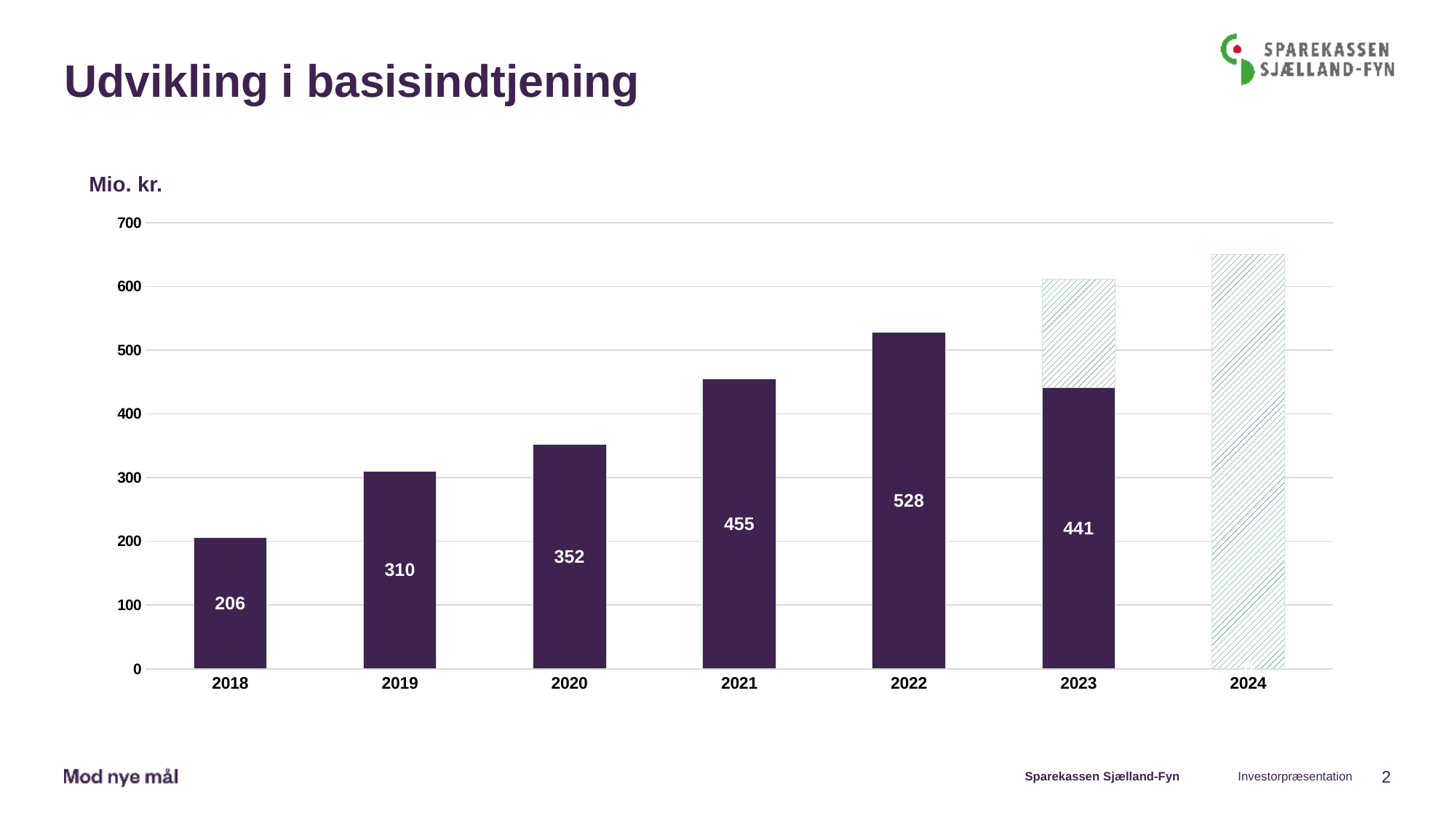
Which year has the lowest value? 2018 How many years are shown on the x axis? 7 What is the difference between the values for 2019 and 2018? 104 Which is larger, the value for 2021 or the value for 2020? 2021 What unit is shown above the y axis? Mio. kr. What is the difference between the values for 2022 and 2021? 73 Is the value for the hatched 2024 bar greater or less than 600? greater What is the value for 2018? 206 What is the value for 2022? 528 What is the value printed on the solid bar for 2023? 441 What is the value for 2020? 352 What kind of chart is shown on the slide? bar chart